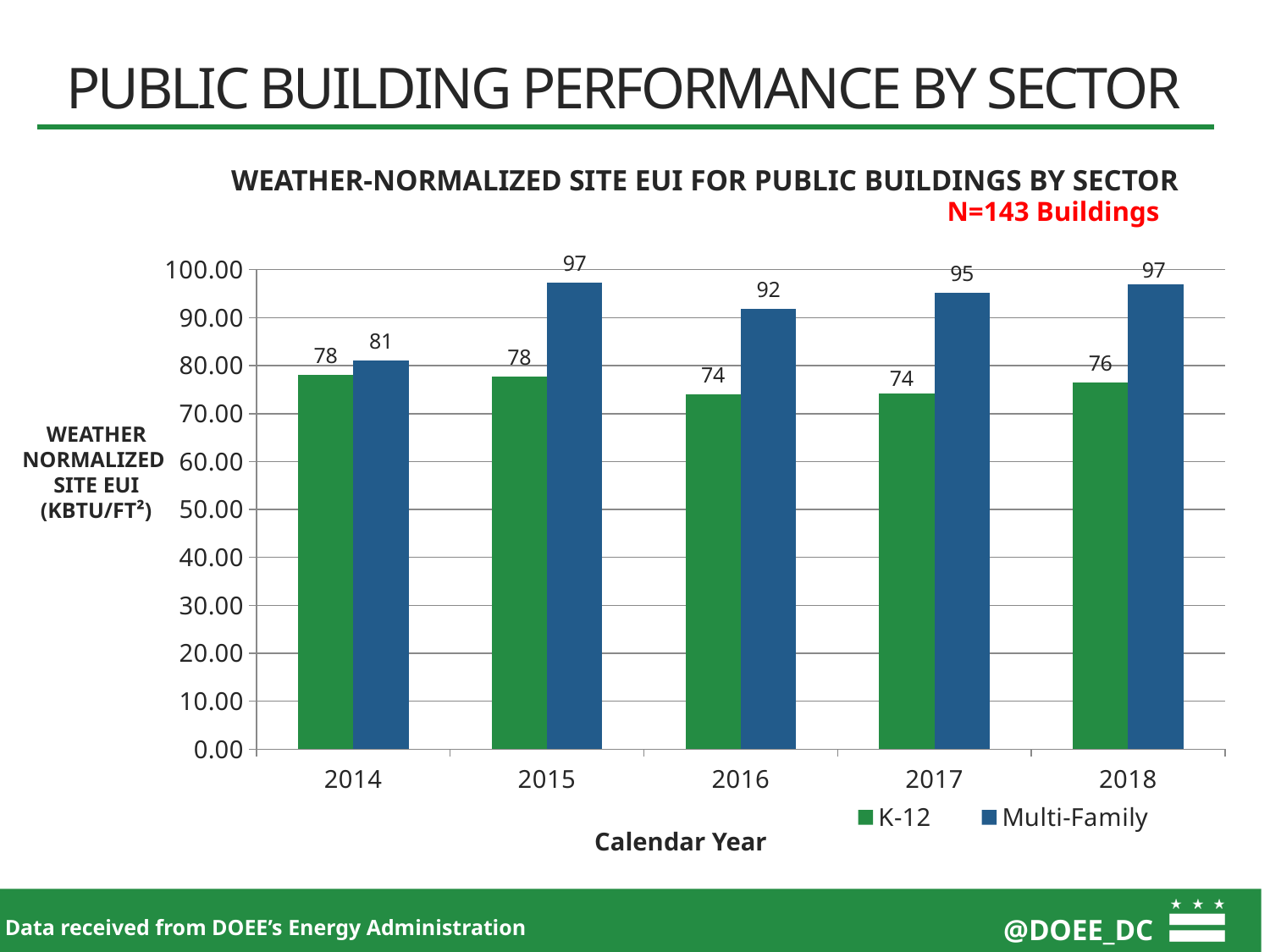
What colour are the Multi-Family bars? Blue What is the K-12 value for 2018? 76 What is the K-12 value for 2014? 78 What is the difference between the Multi-Family and K-12 values in 2017? 21 Does the K-12 value rise or fall from 2015 to 2016? Fall What is the number of buildings stated above the chart? N=143 Buildings What is the Multi-Family value for 2016? 92 Which year has the lowest Multi-Family value? 2014 How many series does the legend list? 2 What kind of chart is shown on the slide? Bar chart How many calendar years are shown on the x axis? 5 Which is larger in 2015, the K-12 value or the Multi-Family value? Multi-Family